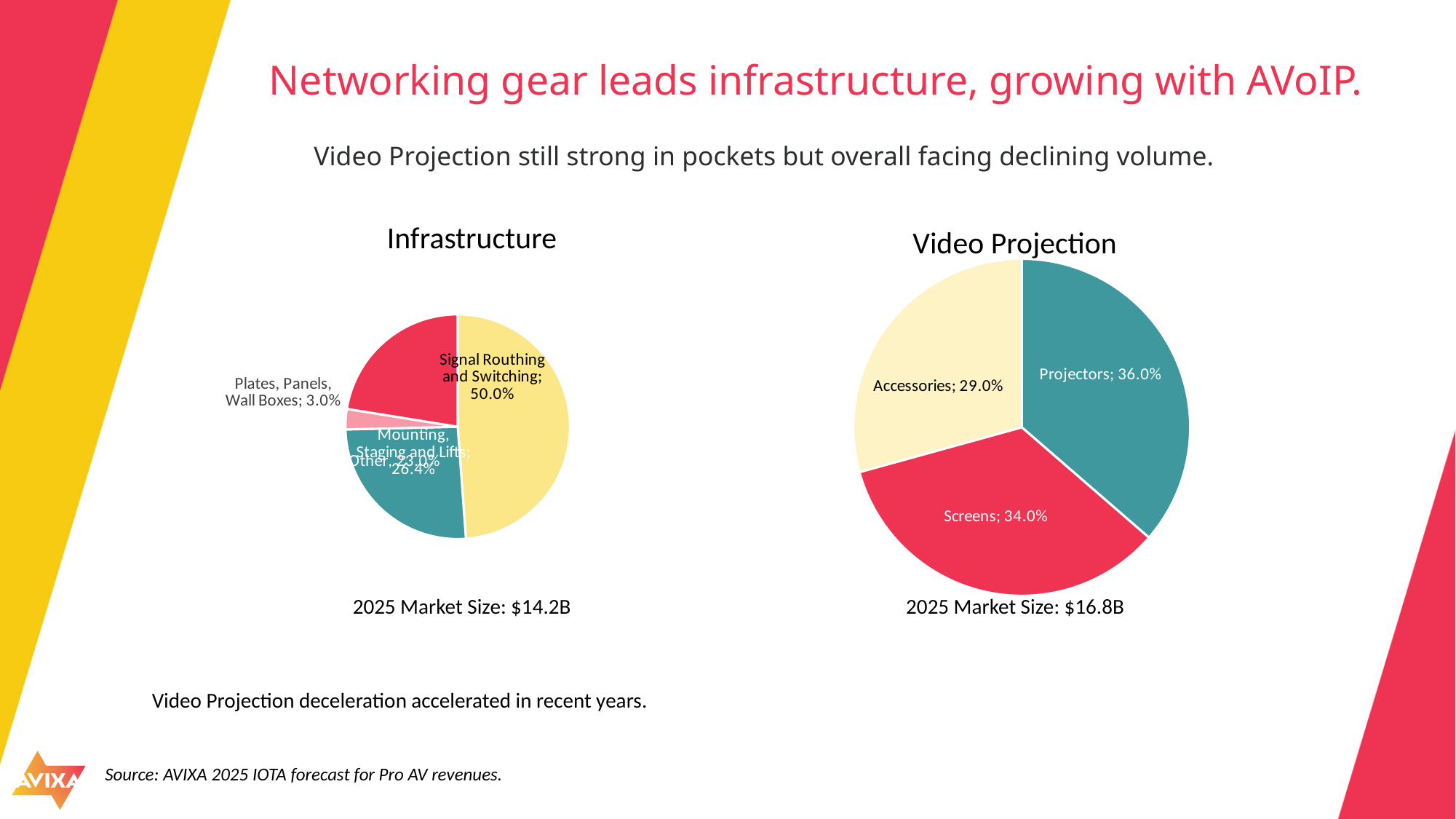
In the Video Projection chart, what share do Screens hold? 34.0% In the Video Projection chart, what is the difference between the Projectors share and the Screens share? 2.0% In the Video Projection chart, which category has the largest share? Projectors What type of chart is the Infrastructure chart? Pie chart In the Video Projection chart, which category has the smallest share? Accessories In the Infrastructure chart, what share does Plates, Panels, Wall Boxes hold? 3.0% In the Video Projection chart, what share do Projectors hold? 36.0% How many slices does the Video Projection pie chart have? 3 What 2025 market size is shown under the Video Projection chart? $16.8B In the Video Projection chart, what share do Accessories hold? 29.0% In the Infrastructure chart, which category has the smallest share? Plates, Panels, Wall Boxes In the Infrastructure chart, what share does Signal Routhing and Switching hold? 50.0%